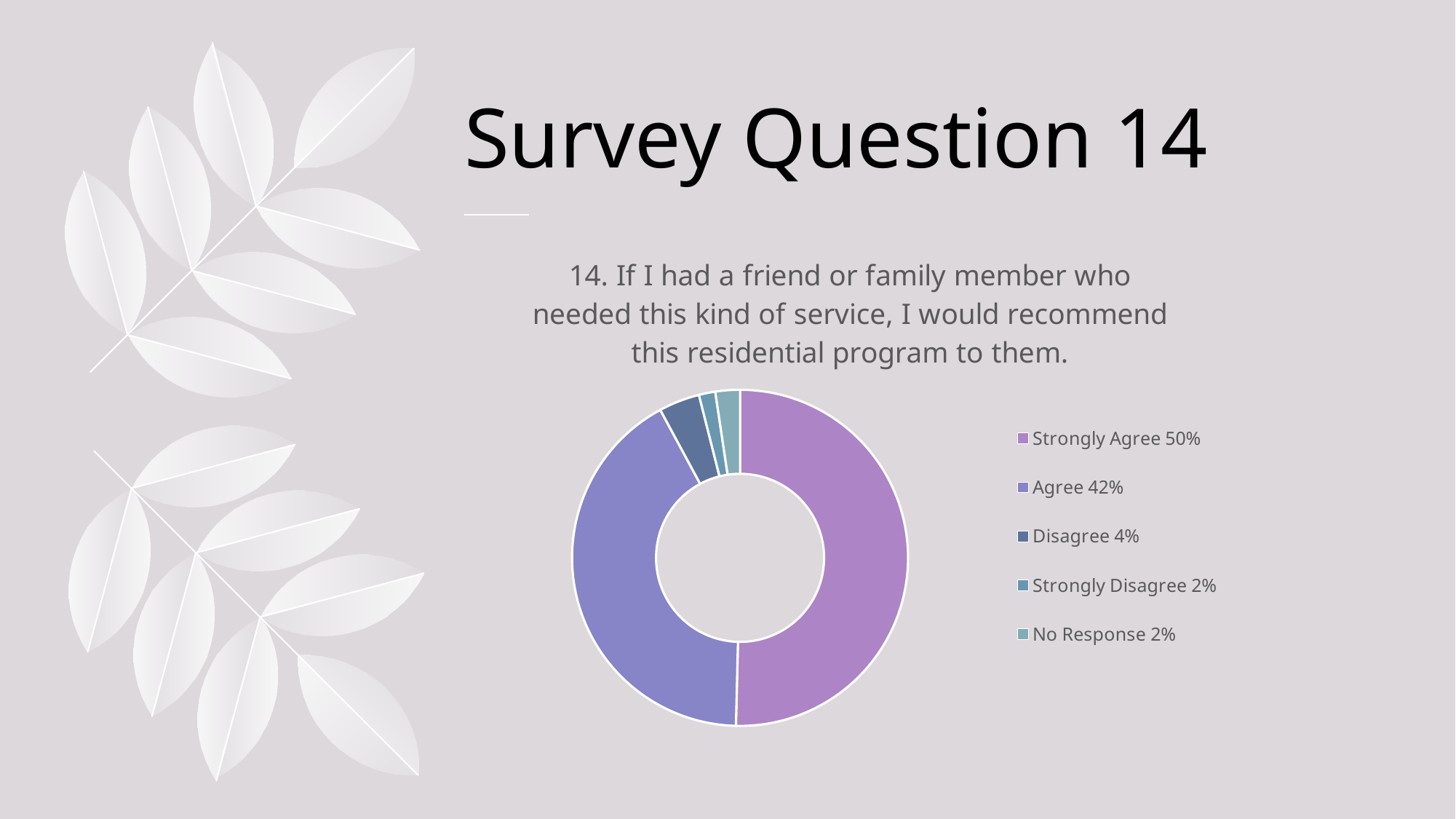
What percentage of respondents answered Agree? 42% What percentage of respondents answered Disagree? 4% Which is larger, the share for Agree or the share for Disagree? Agree What is the combined percentage of Strongly Agree and Agree responses? 92% What is the difference in percentage points between Strongly Agree and Agree? 8 What percentage of respondents answered Strongly Agree? 50% Which response category has the largest share? Strongly Agree What kind of chart is shown on the slide? Doughnut chart What is the title of the slide? Survey Question 14 What percentage of respondents answered Strongly Disagree? 2% What is the difference in percentage points between Disagree and Strongly Disagree? 2 How many response categories does the legend list? 5